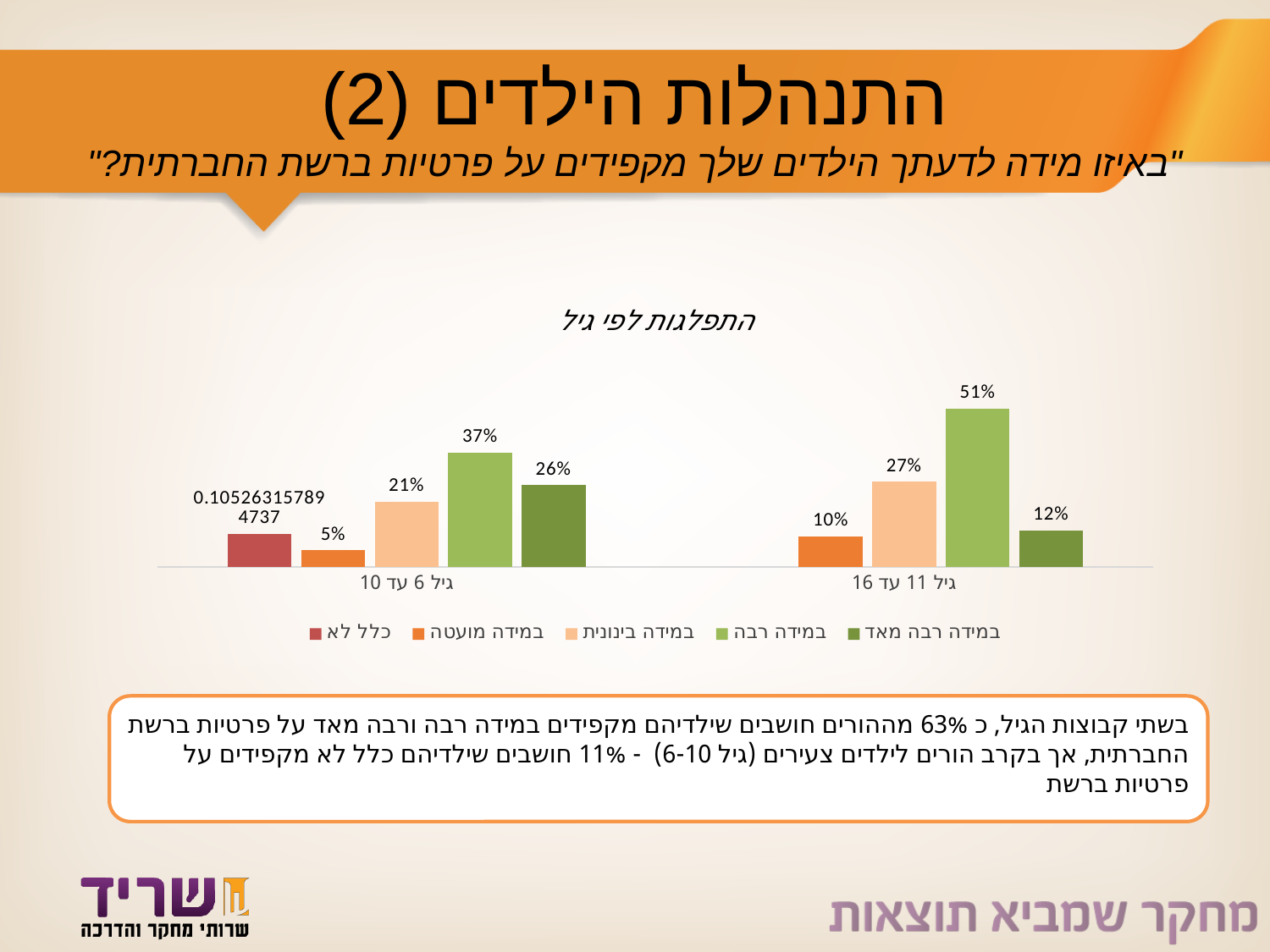
What is the value for "במידה רבה מאד" in the "גיל 6 עד 10" group? 26% What is the difference between "במידה רבה" in the "גיל 11 עד 16" group and "במידה רבה" in the "גיל 6 עד 10" group? 14% Which series has the highest value in the "גיל 11 עד 16" group? במידה רבה What is the title of the chart? התפלגות לפי גיל What is the value for "במידה בינונית" in the "גיל 11 עד 16" group? 27% Which is larger: "במידה רבה מאד" for "גיל 6 עד 10" or "במידה רבה מאד" for "גיל 11 עד 16"? גיל 6 עד 10 How many age groups are shown on the x axis? 2 What is the value for "במידה מועטה" in the "גיל 6 עד 10" group? 5% What is the value for "במידה רבה" in the "גיל 11 עד 16" group? 51% What kind of chart is shown on the slide? bar chart Which series has the lowest value in the "גיל 6 עד 10" group? במידה מועטה How many series does the legend list? 5